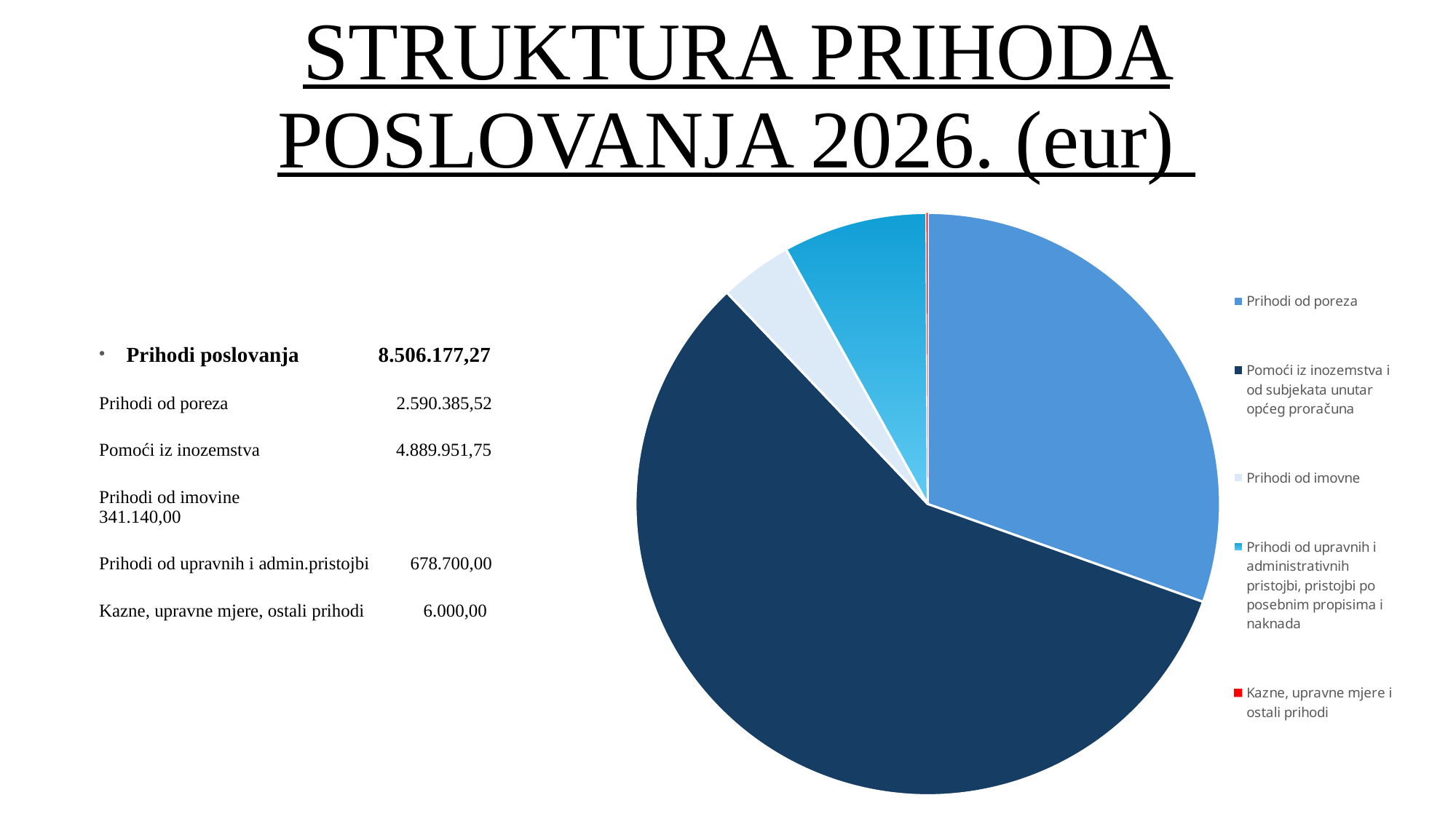
Which slice is larger: Prihodi od poreza or Prihodi od imovne? Prihodi od poreza What colour is the legend marker for Kazne, upravne mjere i ostali prihodi? red According to the slide, what is the value for Kazne, upravne mjere, ostali prihodi? 6.000,00 Which slice is larger: Prihodi od upravnih i administrativnih pristojbi or Prihodi od imovne? Prihodi od upravnih i administrativnih pristojbi How many entries does the pie chart's legend list? 5 How many slices does the pie chart have? 5 According to the slide, what is the value for Prihodi od poreza? 2.590.385,52 Which category has the smallest slice of the pie chart? Kazne, upravne mjere i ostali prihodi Which category has the largest slice of the pie chart? Pomoći iz inozemstva i od subjekata unutar općeg proračuna What kind of chart is shown on the slide? pie chart According to the slide, what is the value for Pomoći iz inozemstva? 4.889.951,75 What is the difference between the values for Pomoći iz inozemstva and Prihodi od poreza shown on the slide? 2.299.566,23